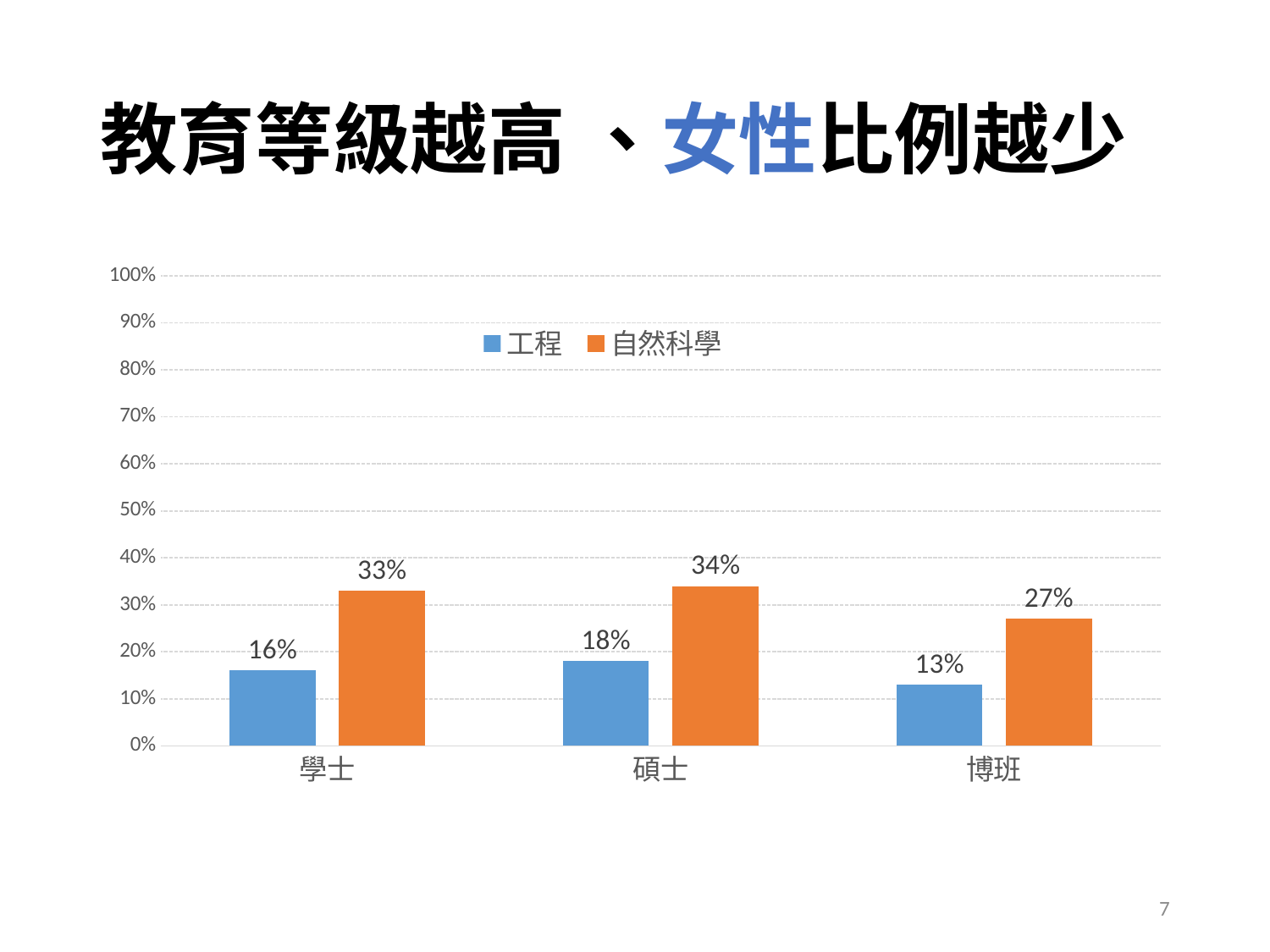
How many series does the legend list? 2 Which category has the highest value for 自然科學? 碩士 Which is larger in the 學士 category, 工程 or 自然科學? 自然科學 How many categories are shown on the x axis? 3 Which category has the lowest value for 工程? 博班 What is the value for 工程 in the 學士 category? 16% What is the value for 自然科學 in the 碩士 category? 34% What kind of chart is shown on the slide? bar chart What is the difference between 自然科學 and 工程 in the 博班 category? 14% Which colour represents the 自然科學 series? orange Is the value for 自然科學 in the 學士 category greater or less than 40%? less What is the value for 工程 in the 博班 category? 13%